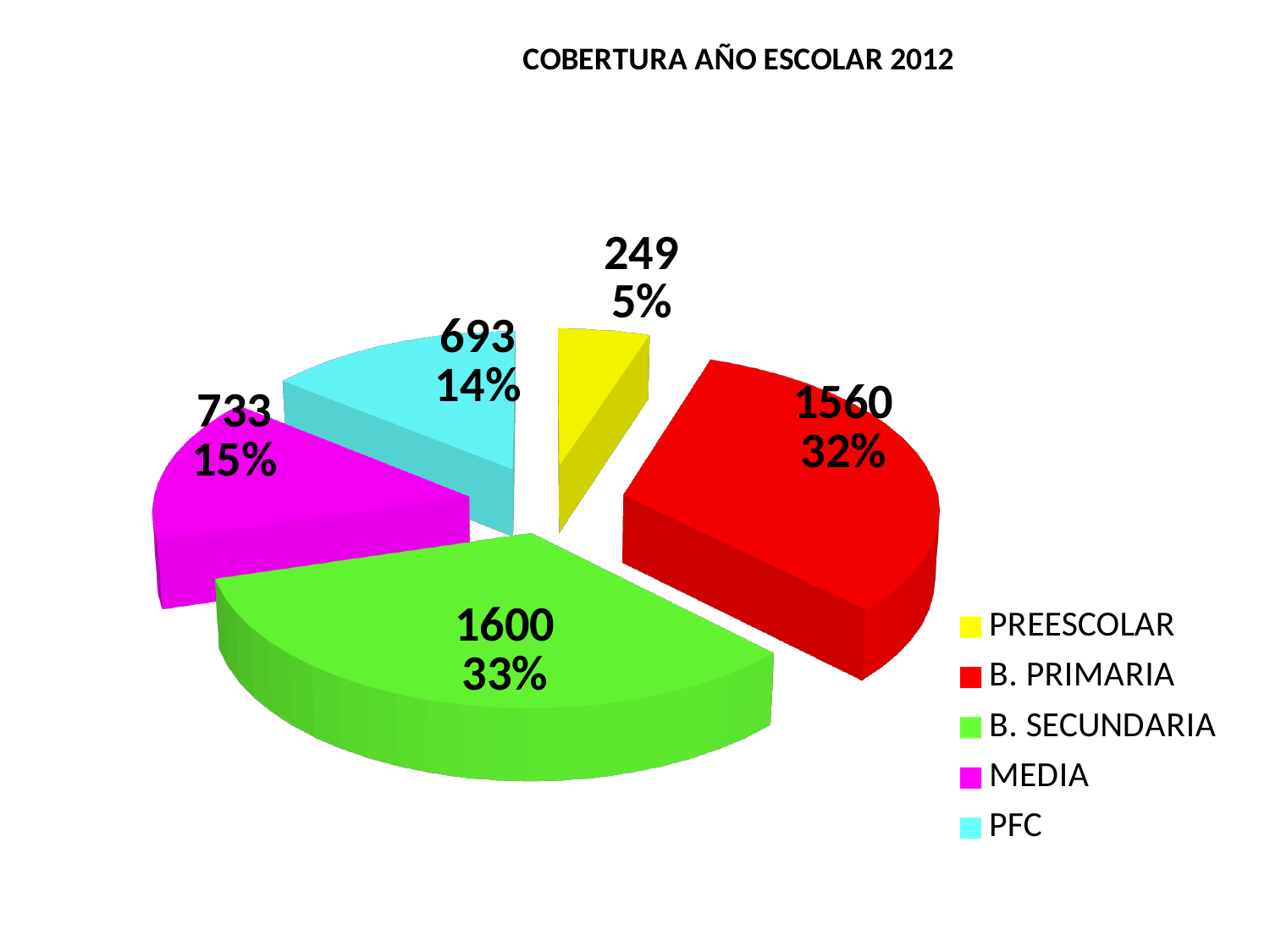
How many categories does the chart show? 5 What percentage share does PREESCOLAR have? 5% What is the value for MEDIA? 733 Which is larger, the value for MEDIA or the value for PFC? MEDIA What kind of chart is shown on the slide? Pie chart Which category has the highest value? B. SECUNDARIA What is the title of the chart? COBERTURA AÑO ESCOLAR 2012 What percentage share does B. SECUNDARIA have? 33% Which category has the lowest value? PREESCOLAR What is the difference between the values for B. SECUNDARIA and B. PRIMARIA? 40 What is the value for B. PRIMARIA? 1560 What is the value for PFC? 693